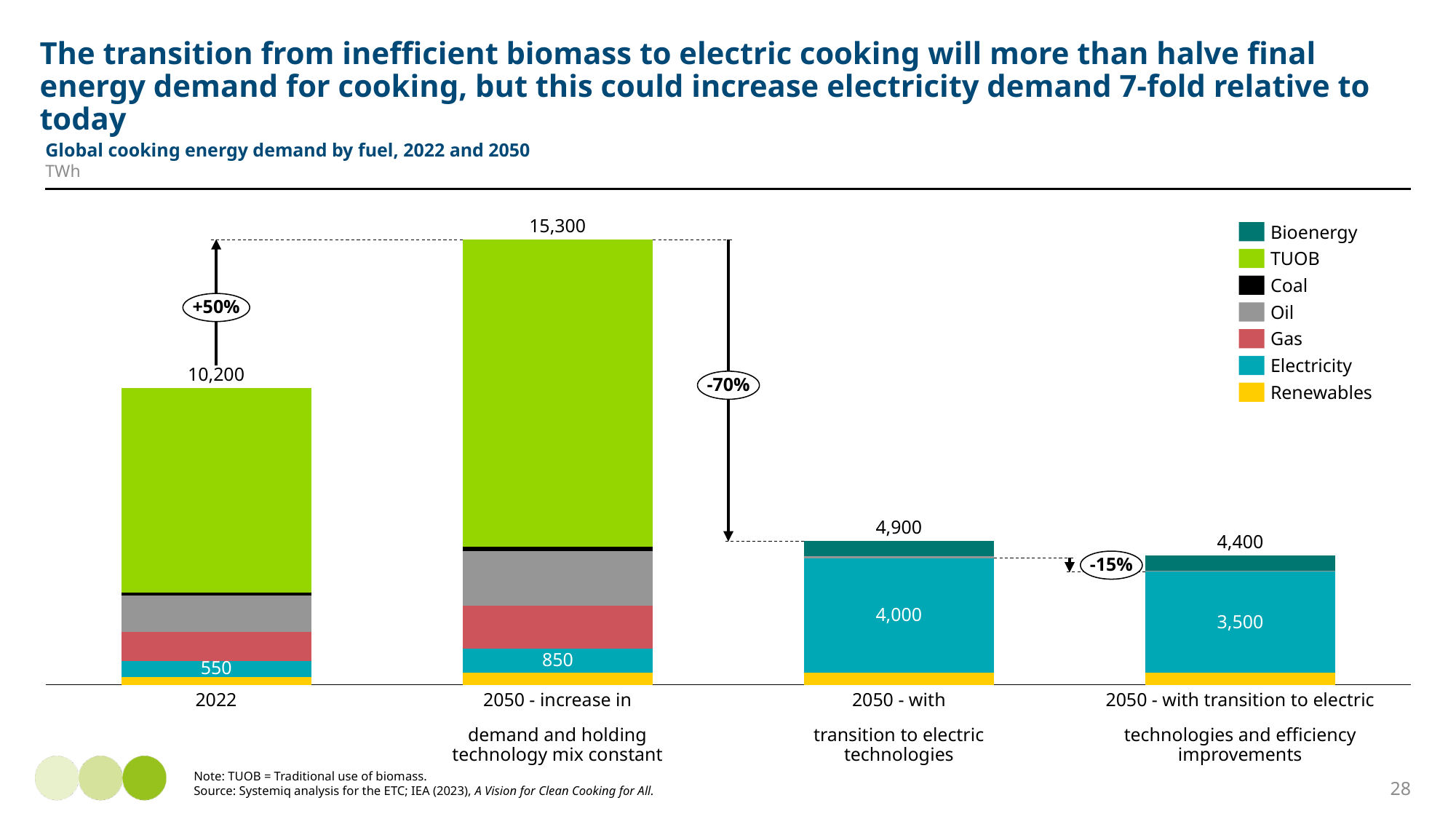
What is the total global cooking energy demand shown for 2022? 10,200 What is the Electricity value in the '2050 - with transition to electric technologies' bar? 4,000 How many fuel series does the legend list? 7 What unit is the chart measured in? TWh Which is larger: the Electricity value in 2022 or in '2050 - increase in demand and holding technology mix constant'? 2050 - increase in demand and holding technology mix constant What is the difference between the totals of the 2022 bar and the '2050 - increase in demand and holding technology mix constant' bar? 5,100 What is the difference in Electricity between the '2050 - with transition to electric technologies' bar and the '2050 - with transition to electric technologies and efficiency improvements' bar? 500 Which scenario bar has the highest total? 2050 - increase in demand and holding technology mix constant What is the Electricity value in the 2022 bar? 550 What is the total for the '2050 - increase in demand and holding technology mix constant' bar? 15,300 How many bars (scenarios) are shown on the chart? 4 Which scenario bar has the lowest total? 2050 - with transition to electric technologies and efficiency improvements